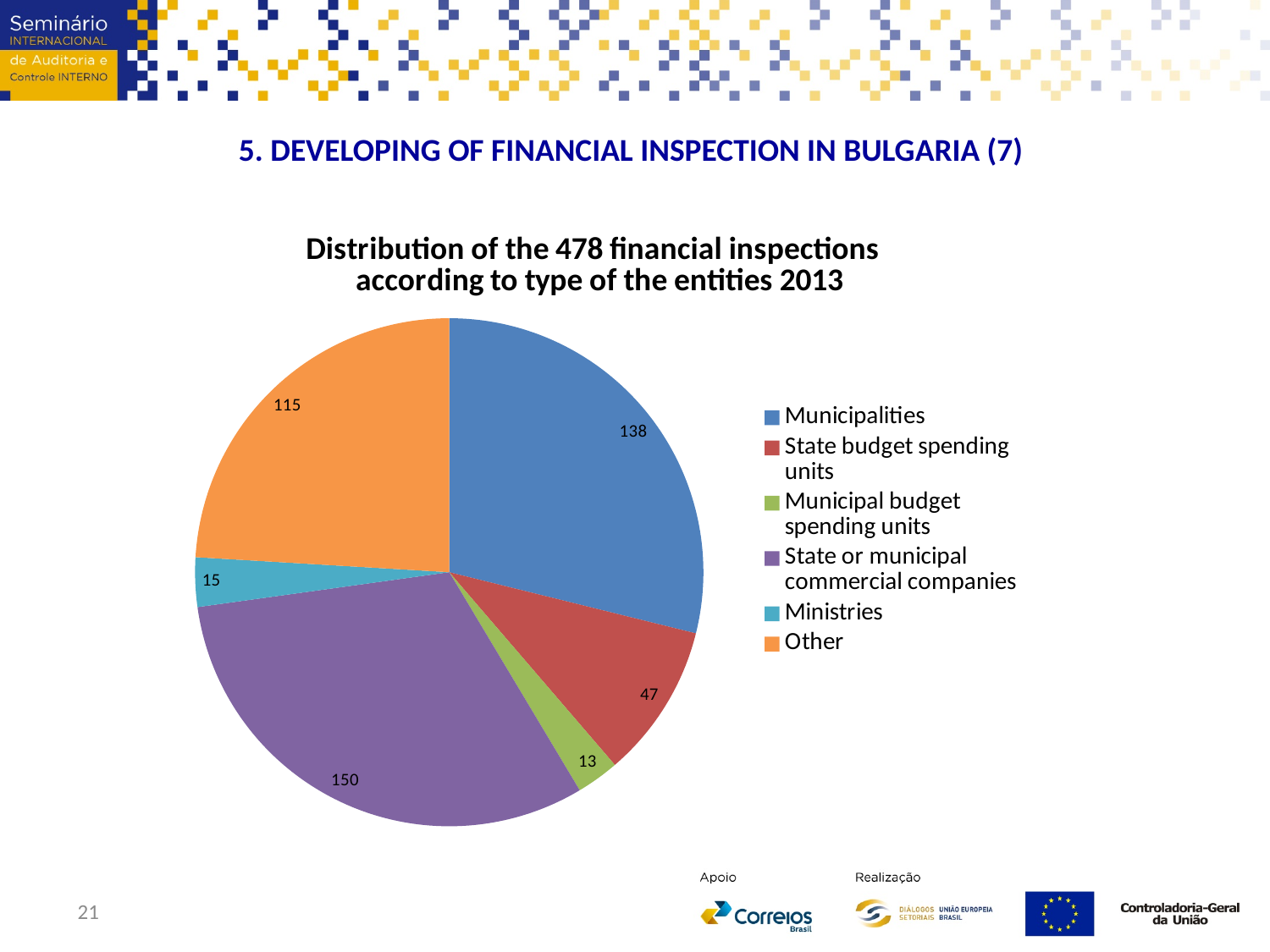
What share of the 478 inspections does the Other slice represent? 24.1% What is the value for Municipal budget spending units? 13 What is the title of the chart? Distribution of the 478 financial inspections according to type of the entities 2013 What is the difference between the inspections for State or municipal commercial companies and for Municipalities? 12 How many financial inspections were carried out in Municipalities? 138 Which entity type has the largest number of financial inspections? State or municipal commercial companies Which entity type has the smallest number of financial inspections? Municipal budget spending units What is the value for Ministries? 15 What type of chart is shown on the slide? Pie chart How many entity types are shown in the pie chart? 6 Which has more inspections, State budget spending units or Other? Other What is the value for State or municipal commercial companies? 150